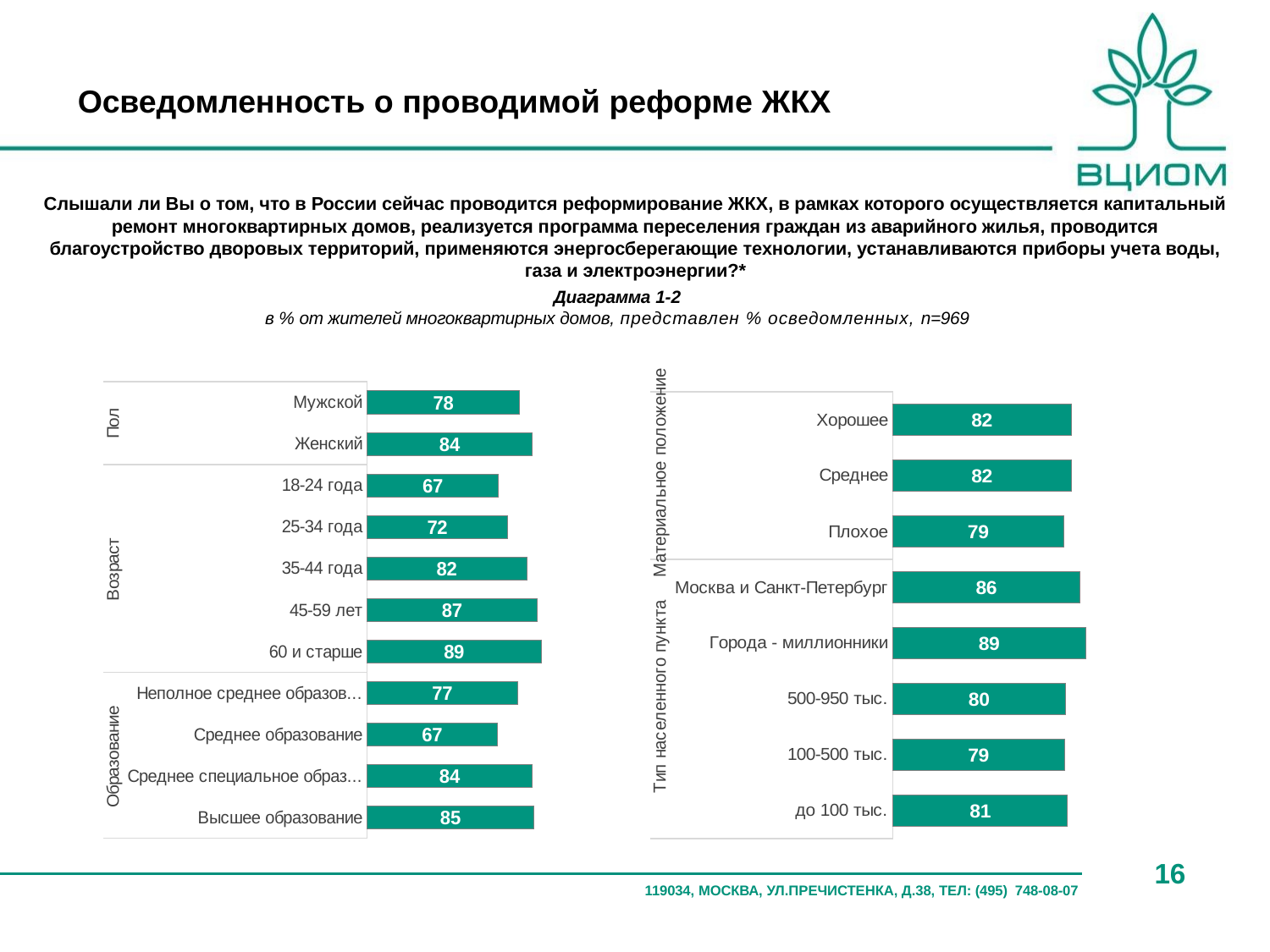
In the right chart, what is the difference between the values for Москва и Санкт-Петербург and до 100 тыс.? 5 What type of chart is shown on the left of the slide? Bar chart In the left chart, what is the difference between the values for Женский and Мужской? 6 In the left chart, which age group (Возраст) has the highest value? 60 и старше In the left chart, what is the value for 45-59 лет? 87 In the right chart, which category has the highest value? Города - миллионники How many categories are plotted in the right chart? 8 In the right chart, what is the value for Плохое? 79 In the left chart, which age group (Возраст) has the lowest value? 18-24 года In the left chart, which is larger: the value for Высшее образование or the value for Среднее образование? Высшее образование In the left chart, what is the value for Женский? 84 In the right chart, what is the value for Города - миллионники? 89